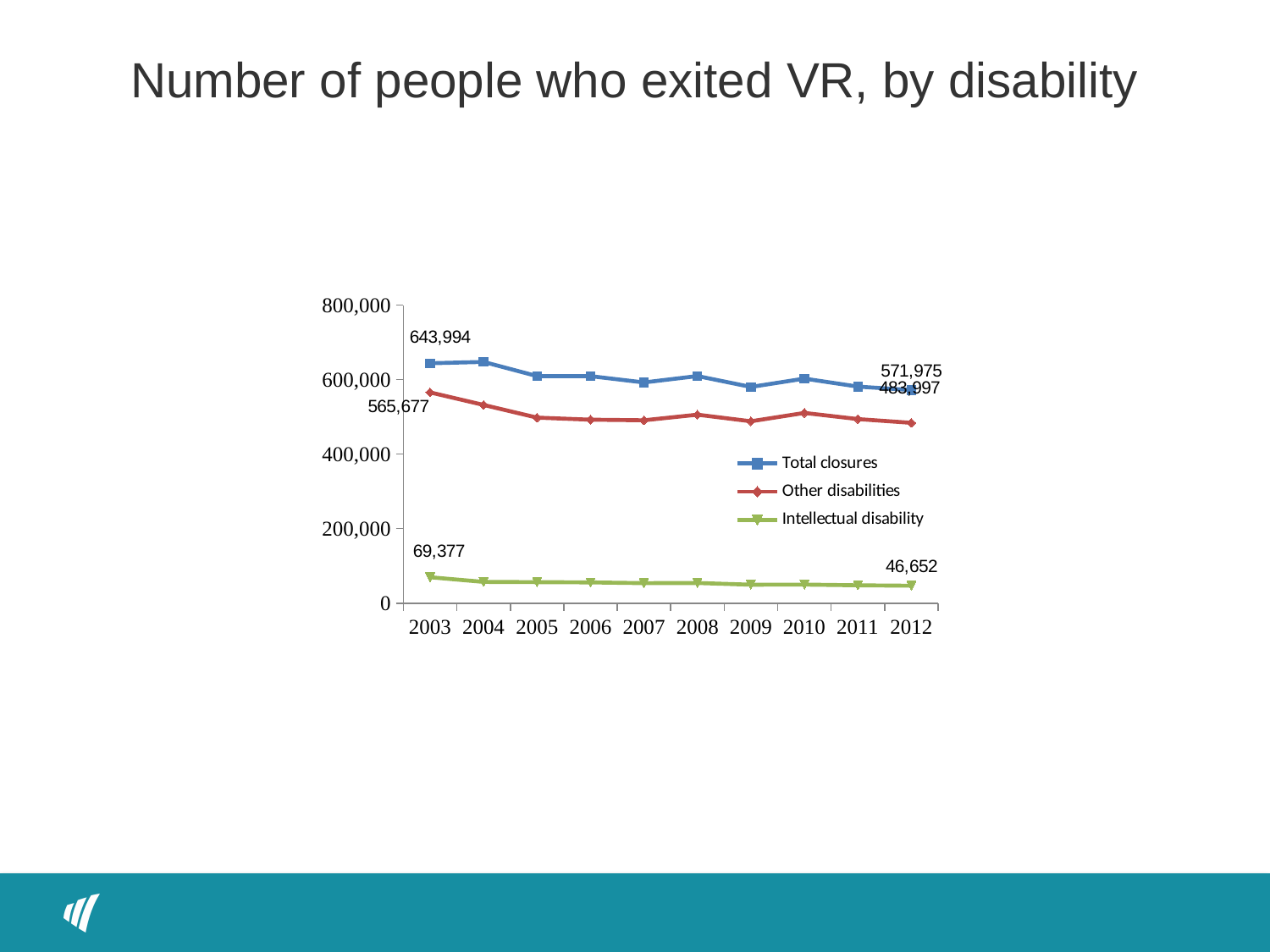
What was the value for Total closures in 2012? 571,975 What kind of chart is shown on the slide? Line chart What was the value for Other disabilities in 2003? 565,677 What was the value for Total closures in 2003? 643,994 Is the value for Other disabilities in 2008 greater or less than 600,000? less How many years are shown on the x axis? 10 What was the value for Intellectual disability in 2012? 46,652 Do the values for Total closures generally rise or fall from 2003 to 2012? Fall What was the value for Intellectual disability in 2003? 69,377 By how much did Total closures decrease from 2003 to 2012? 72,019 By how much did Intellectual disability closures decrease from 2003 to 2012? 22,725 How many series does the legend list? 3